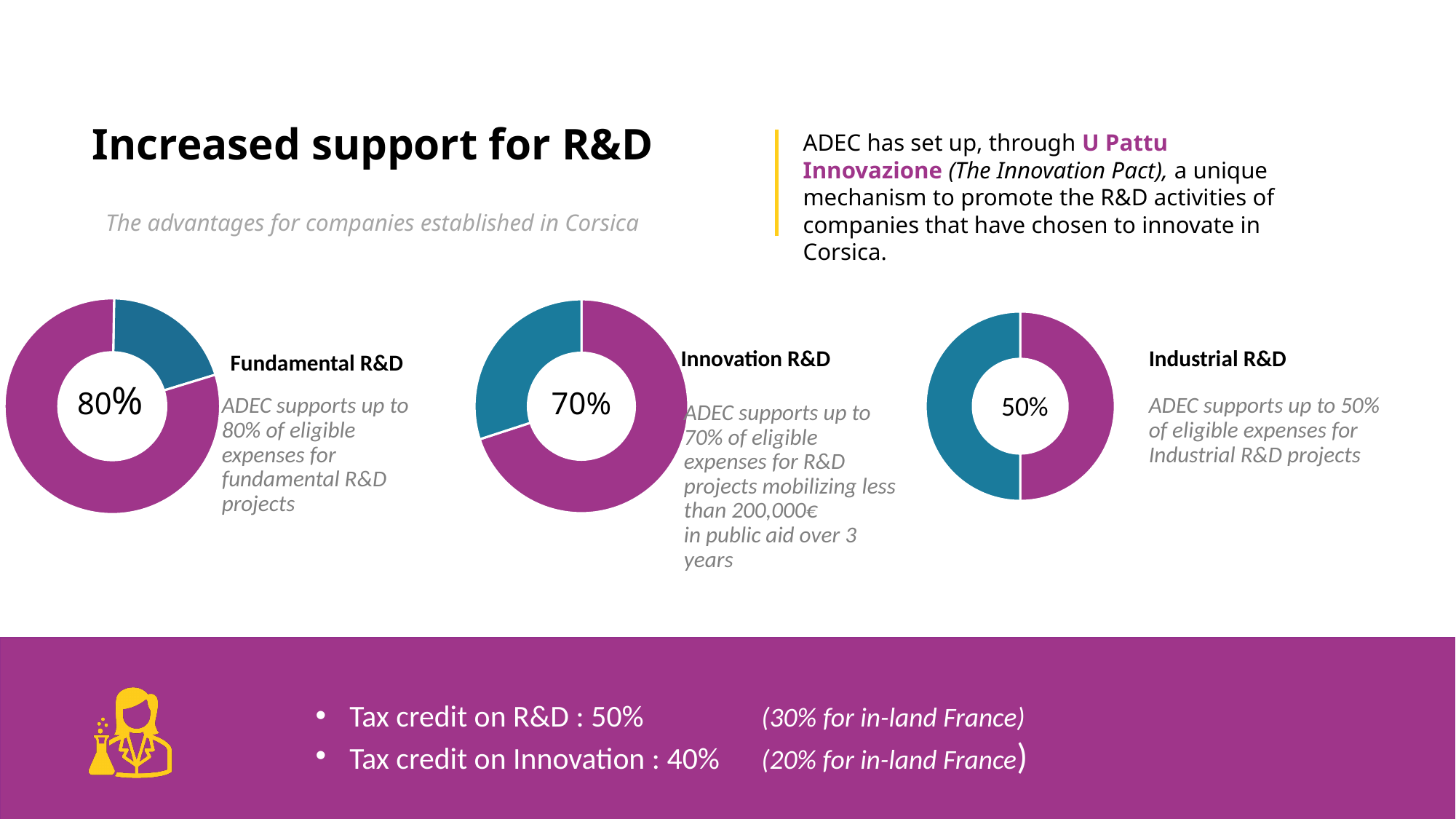
What is the difference between the percentage shown in the Innovation R&D chart and the percentage shown in the Industrial R&D chart? 20% What value is shown in the centre of the Fundamental R&D donut chart? 80% In the Fundamental R&D donut chart, what share of the ring does the purple slice represent? 80% Which is larger: the percentage in the Innovation R&D chart or the percentage in the Industrial R&D chart? Innovation R&D How many donut charts are on the slide? 3 What value is shown in the centre of the Industrial R&D donut chart? 50% Which of the three donut charts shows the highest support percentage? Fundamental R&D What value is shown in the centre of the Innovation R&D donut chart? 70% Which of the three donut charts shows the lowest support percentage? Industrial R&D What kind of chart is used to show the support percentages on this slide? Donut chart What is the difference between the percentage shown in the Fundamental R&D chart and the percentage shown in the Innovation R&D chart? 10%